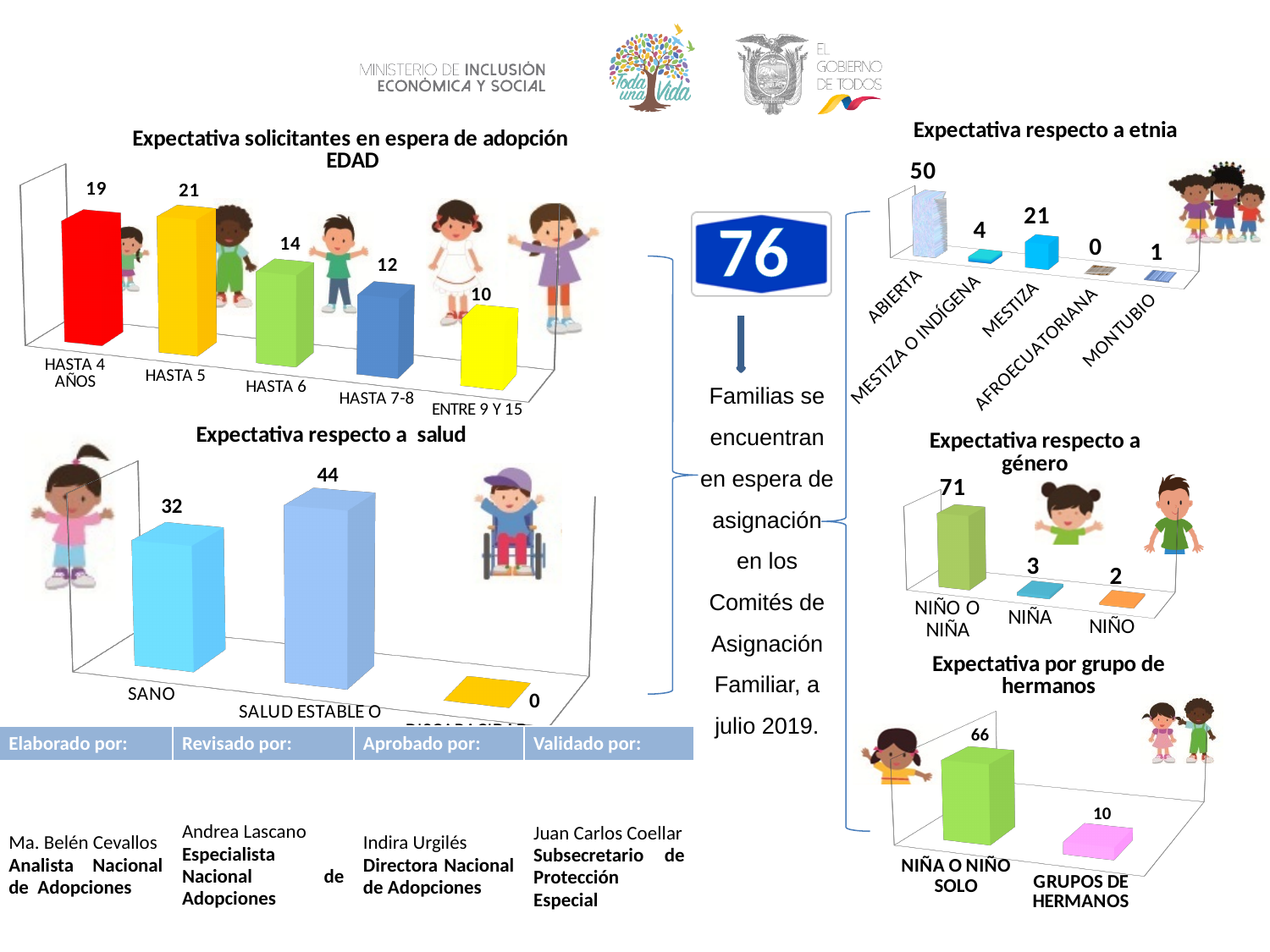
In the 'Expectativa solicitantes en espera de adopción EDAD' chart, what is the difference between HASTA 4 AÑOS and HASTA 7-8? 7 In the 'Expectativa respecto a salud' chart, what is the value for SANO? 32 In the 'Expectativa solicitantes en espera de adopción EDAD' chart, which category has the lowest value? ENTRE 9 Y 15 In the 'Expectativa por grupo de hermanos' chart, what is the difference between NIÑA O NIÑO SOLO and GRUPOS DE HERMANOS? 56 In the 'Expectativa respecto a etnia' chart, what is the value for MESTIZA? 21 In the 'Expectativa solicitantes en espera de adopción EDAD' chart, what is the value for HASTA 5? 21 In the 'Expectativa respecto a salud' chart, which is larger, SANO or SALUD ESTABLE O...? SALUD ESTABLE O... What kind of chart is 'Expectativa por grupo de hermanos'? Bar chart In the 'Expectativa respecto a género' chart, what is the value for NIÑO O NIÑA? 71 In the 'Expectativa respecto a etnia' chart, what is the value for AFROECUATORIANA? 0 In the 'Expectativa respecto a etnia' chart, which category has the highest value? ABIERTA In the 'Expectativa solicitantes en espera de adopción EDAD' chart, how many categories are shown? 5